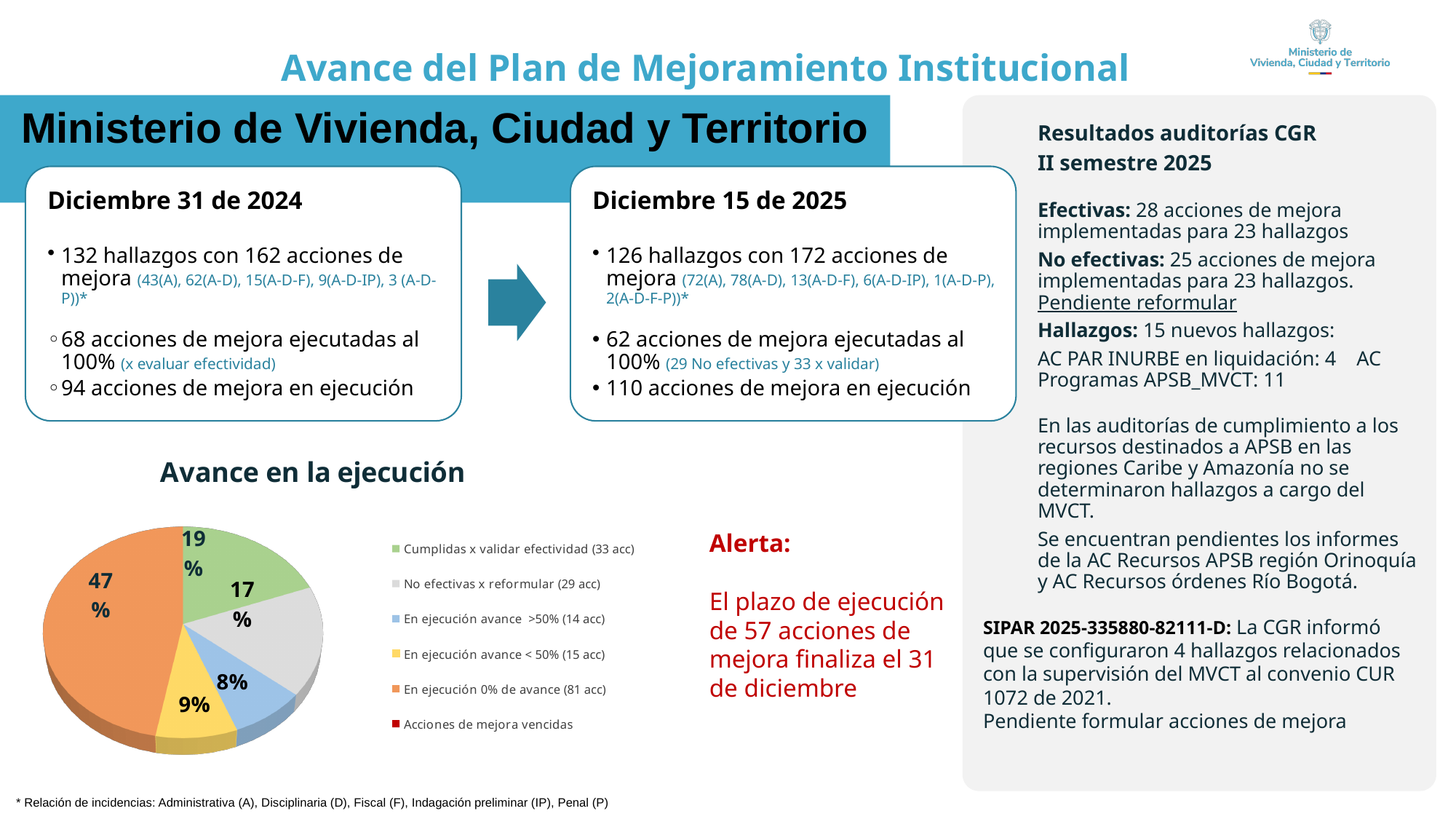
What colour is the "En ejecución 0% de avance (81 acc)" slice in the "Avance en la ejecución" pie chart? Orange In the "Avance en la ejecución" pie chart, what percentage is shown for "Cumplidas x validar efectividad (33 acc)"? 19% In the "Avance en la ejecución" pie chart, what percentage is shown for "En ejecución 0% de avance (81 acc)"? 47% Which labelled slice is the smallest in the "Avance en la ejecución" pie chart? En ejecución avance >50% (14 acc) In the "Avance en la ejecución" pie chart, what percentage is shown for "En ejecución avance < 50% (15 acc)"? 9% What kind of chart is shown under the heading "Avance en la ejecución"? Pie chart In the "Avance en la ejecución" pie chart, what percentage is shown for "En ejecución avance >50% (14 acc)"? 8% Which category has the largest slice in the "Avance en la ejecución" pie chart? En ejecución 0% de avance (81 acc) In the "Avance en la ejecución" pie chart, which is larger: "Cumplidas x validar efectividad" or "No efectivas x reformular"? Cumplidas x validar efectividad How many entries does the legend of the "Avance en la ejecución" pie chart list? 6 In the "Avance en la ejecución" pie chart, what percentage is shown for "No efectivas x reformular (29 acc)"? 17% In the "Avance en la ejecución" pie chart, what is the difference in percentage points between "En ejecución 0% de avance" and "Cumplidas x validar efectividad"? 28